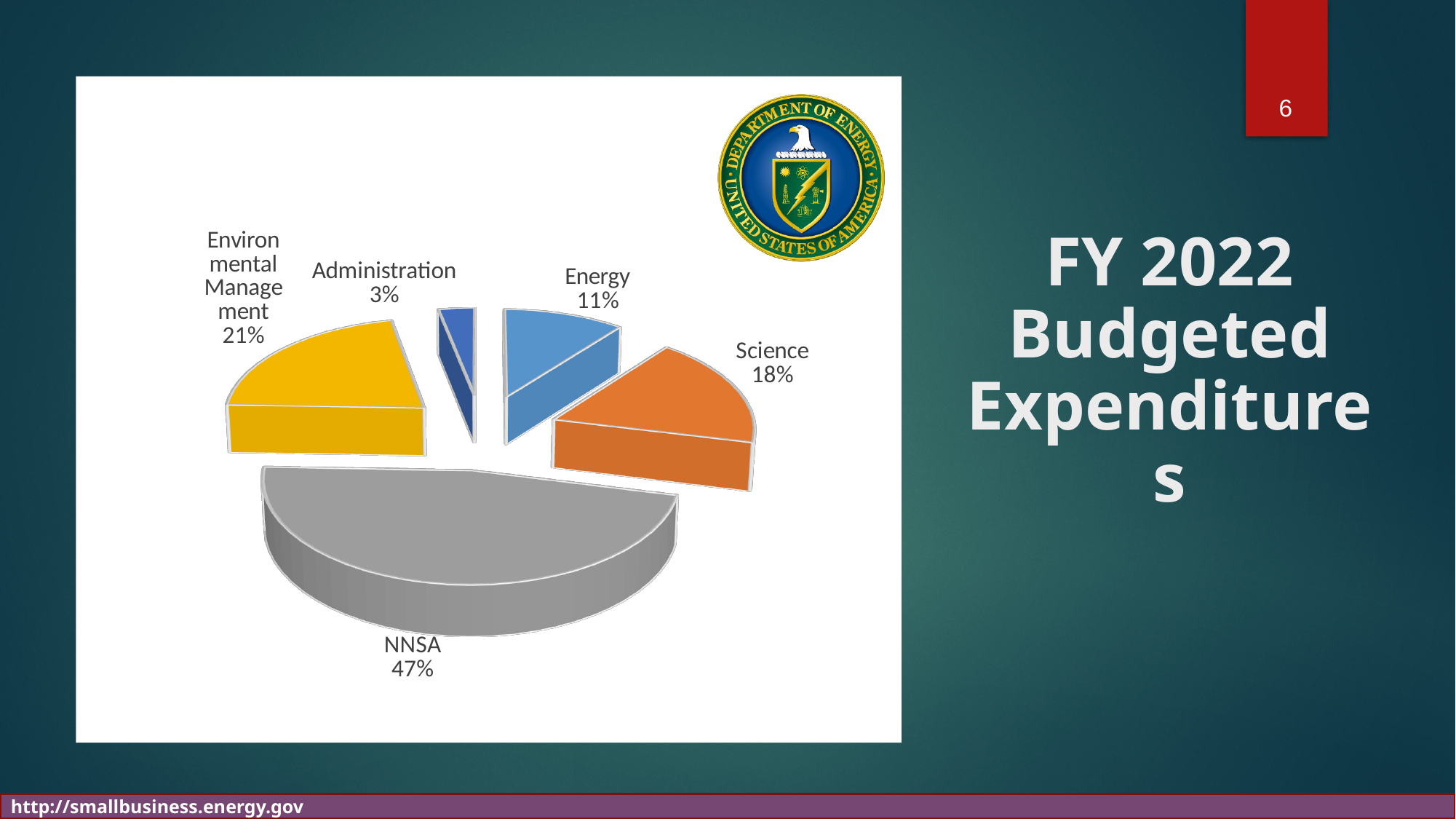
What is the value shown for Science? 18% What is the difference in percentage points between Science and Administration? 15 What is the value shown for Energy? 11% Which category has the largest slice of the pie? NNSA What is the value shown for Environmental Management? 21% What colour is the NNSA slice? Grey Which is larger, the Science slice or the Energy slice? Science How many categories are shown in the pie chart? 5 What share of the pie does NNSA account for? 47% What is the difference in percentage points between NNSA and Environmental Management? 26 Which category has the smallest slice of the pie? Administration What kind of chart is shown on the slide? Pie chart